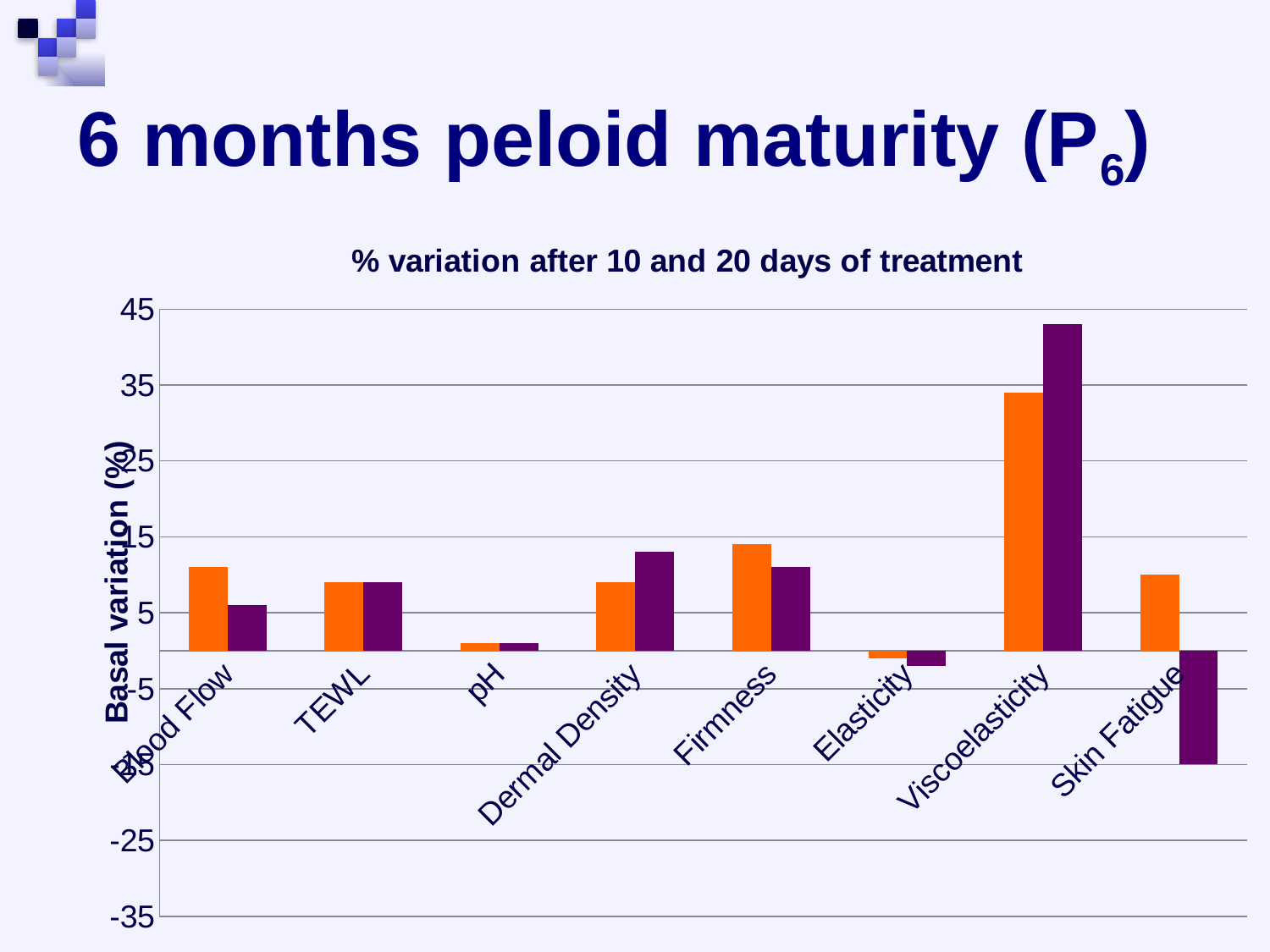
Is the value of the purple bar for Dermal Density greater or less than 5? greater Which has the larger orange bar, Viscoelasticity or Firmness? Viscoelasticity Which category has the lowest (most negative) bar in the chart? Skin Fatigue Is the value of the purple bar for Skin Fatigue greater or less than -5? less How many categories are shown on the x axis of the chart? 8 What is the label of the vertical axis of the chart? Basal variation (%) Is the value of the orange bar for Viscoelasticity greater or less than 25? greater What is the title of the chart? % variation after 10 and 20 days of treatment Which category has the highest bar in the chart? Viscoelasticity What kind of chart is shown on the slide? bar chart